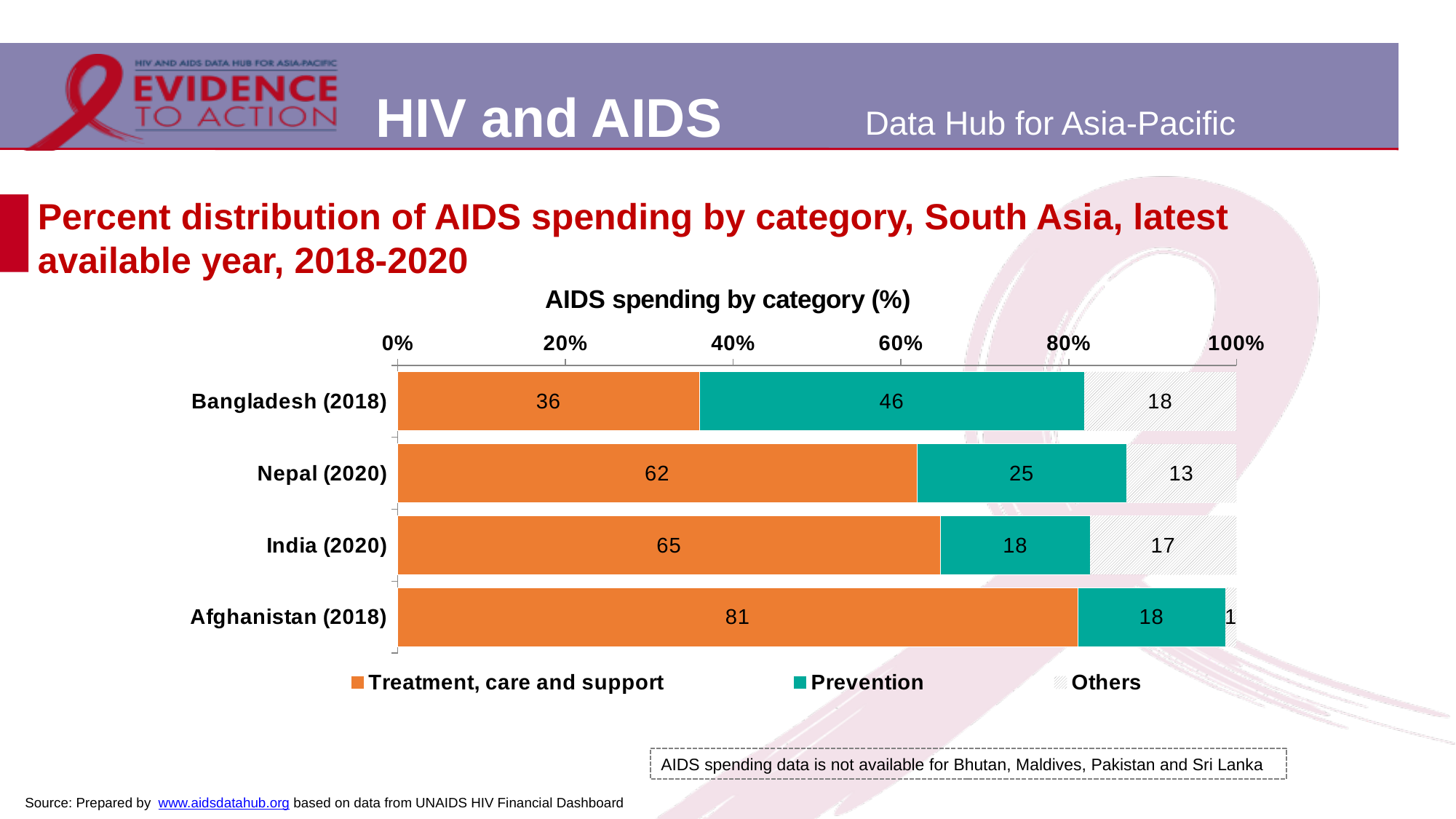
How many countries are shown on the chart? 4 What is the difference between the Treatment, care and support values for Afghanistan (2018) and Bangladesh (2018)? 45 What is the Others value for India (2020)? 17 What is the Prevention value for Bangladesh (2018)? 46 Which country has the highest Treatment, care and support share? Afghanistan (2018) What is the total of the stacked bar for Nepal (2020)? 100 What is the title of the chart? AIDS spending by category (%) Which is larger, the Prevention value for Nepal (2020) or for India (2020)? Nepal (2020) What is the Treatment, care and support value for Nepal (2020)? 62 What kind of chart is shown on the slide? Stacked bar chart How many series does the legend list? 3